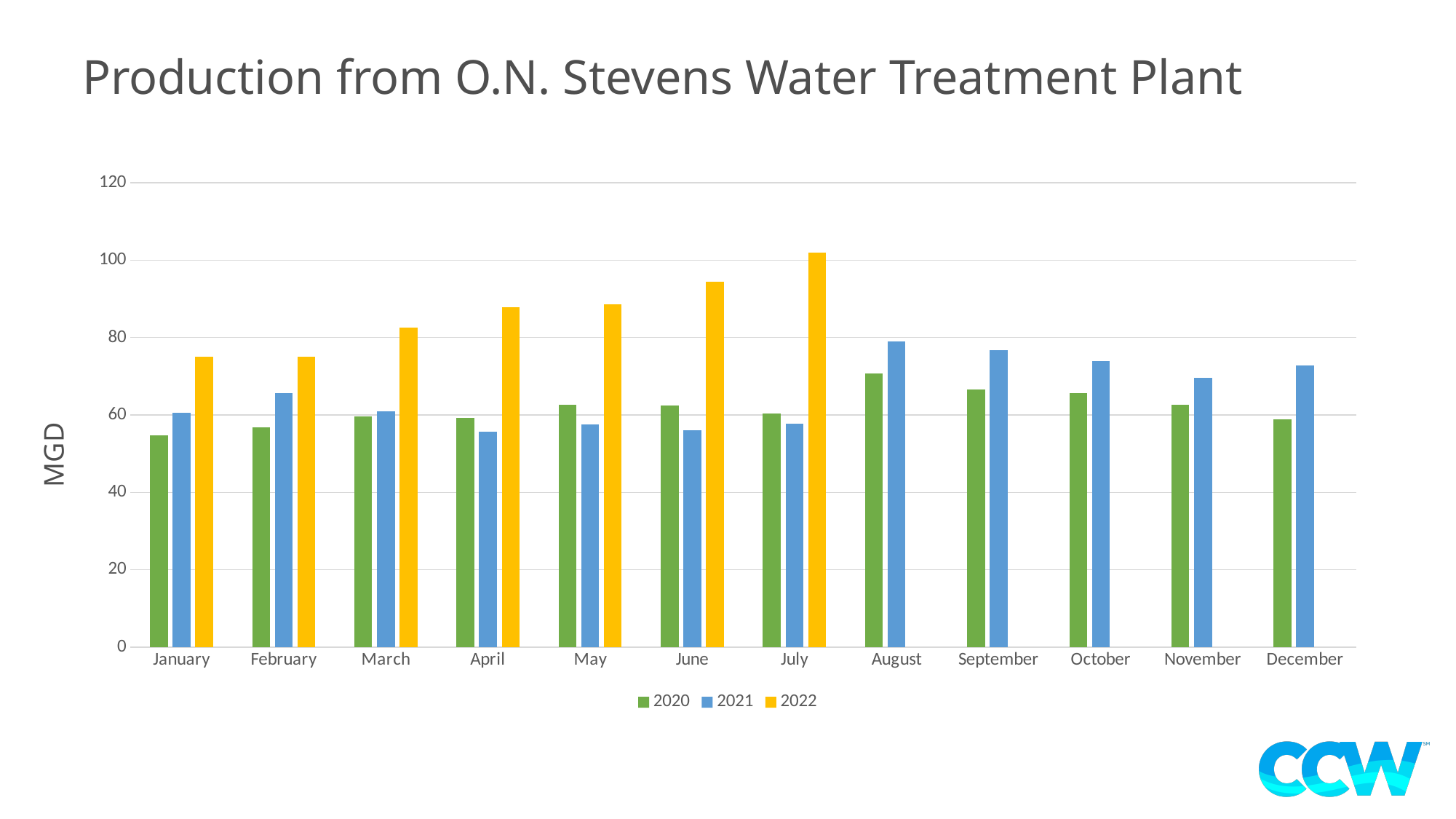
How many months are shown on the x axis? 12 Is the 2022 value for June greater or less than 100? less What is the label on the y axis? MGD In which month is the 2020 bar lowest? January Is the 2022 value for July greater or less than 100? greater In which month is the 2022 bar highest? July How many series does the legend list? 3 Which is larger in April, the 2020 value or the 2021 value? 2020 Do the 2022 values rise or fall from January to July? rise What kind of chart is shown on the slide? bar chart Is the 2020 value for January greater or less than 60? less In which month is the 2021 bar highest? August